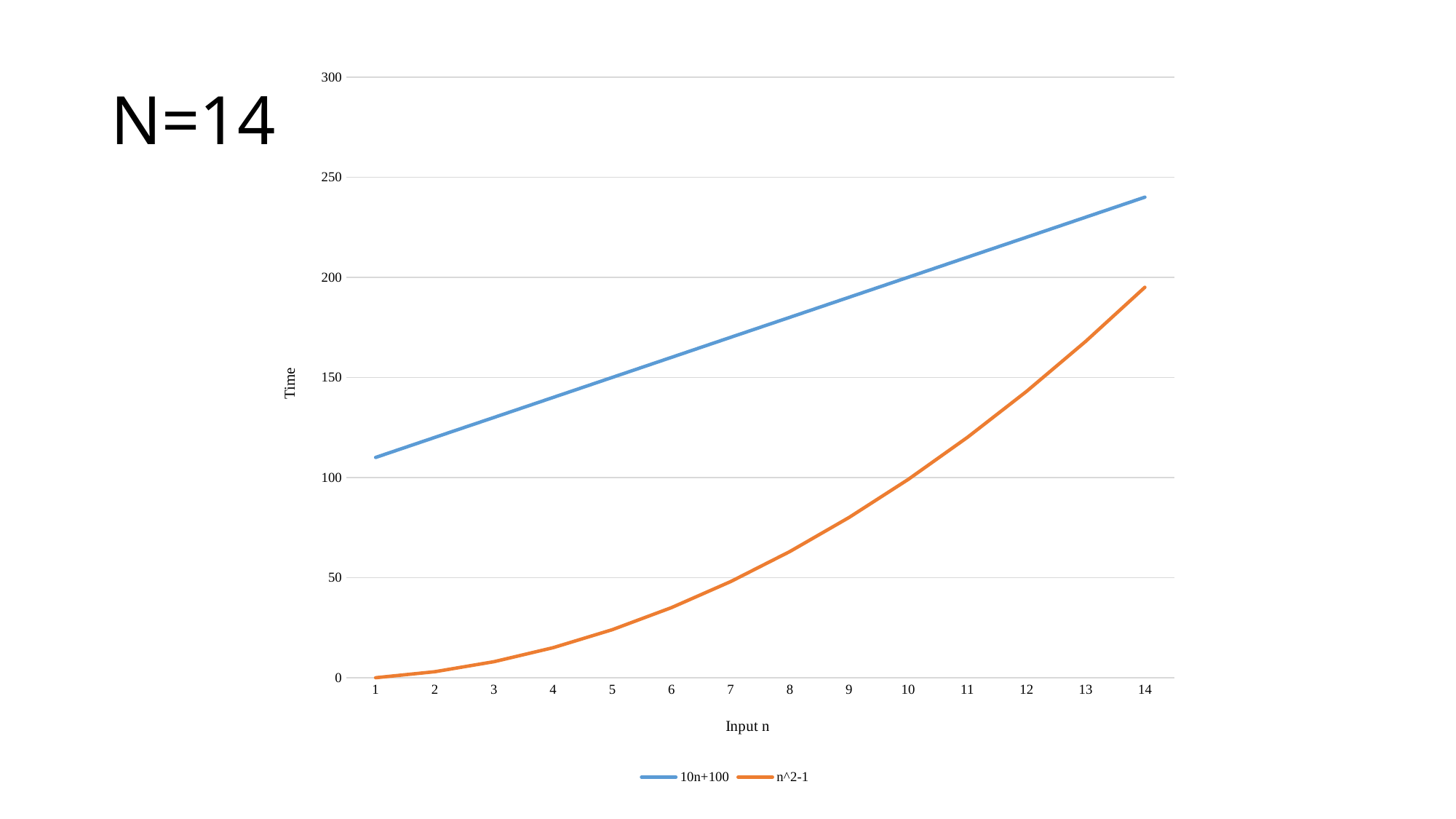
What is the value of n^2-1 at n=1? 0 Does the 10n+100 line rise or fall as Input n increases? rises Is the value of 10n+100 at n=14 greater or less than 200? greater At n=14, which series has the larger value, 10n+100 or n^2-1? 10n+100 What is the label of the x axis? Input n How many points along the x axis does each line cover? 14 Does the n^2-1 line rise or fall as Input n increases? rises What kind of chart is shown on the slide? line chart Is the value of n^2-1 at n=14 greater or less than 200? less Is the value of 10n+100 at n=1 greater or less than 100? greater How many series does the legend list? 2